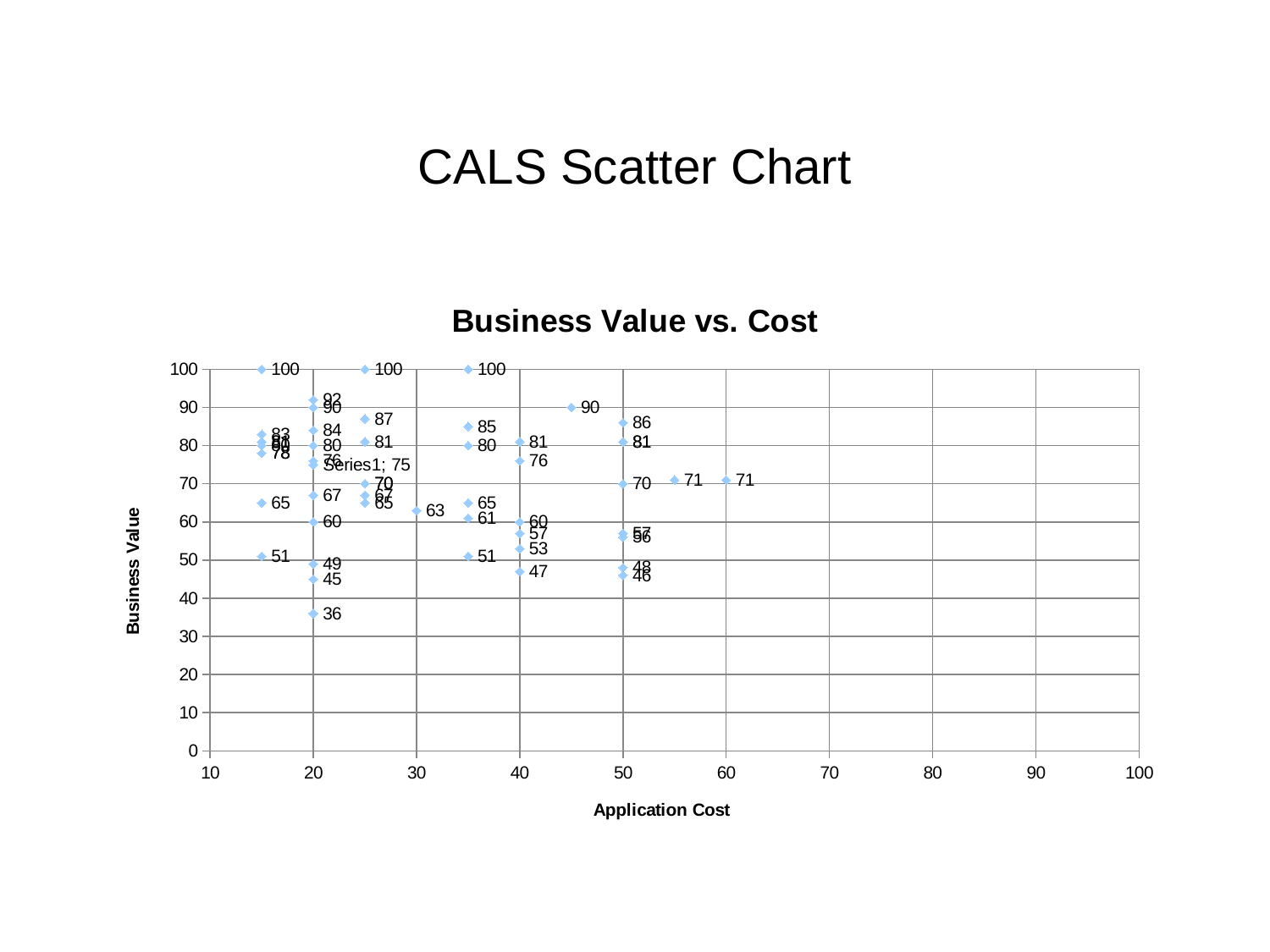
What is the difference in business value between the point at application cost 45 and the point at application cost 30? 27 What is the lowest business value among the points at application cost 40? 47 Which has the higher business value: the point at application cost 45 or the point at application cost 30? the point at application cost 45 What is the business value of the point at application cost 60? 71 Is the business value of the point at application cost 55 greater or less than 80? less What is the lowest business value plotted on the chart? 36 What is the highest business value plotted on the chart? 100 What kind of chart is shown on the slide? scatter chart What is the business value of the point at application cost 45? 90 What is the label of the horizontal axis? Application Cost What is the title of the chart? Business Value vs. Cost What is the business value of the point at application cost 30? 63